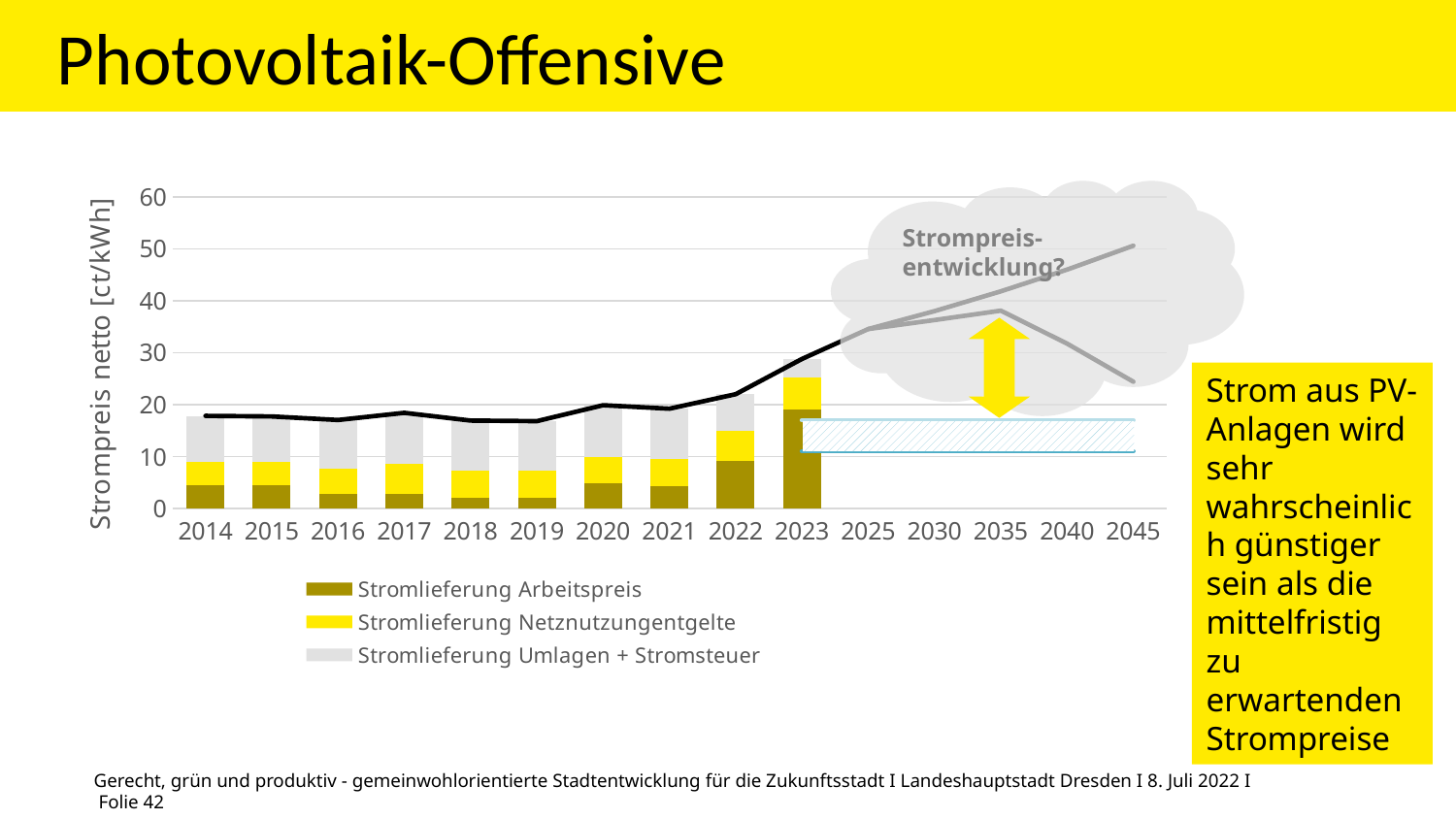
Which year has the highest total stacked bar? 2023 Is the total stacked bar for 2023 greater or less than 20? greater How many series does the legend list? 3 Is the Stromlieferung Arbeitspreis value for 2018 greater or less than 10? less What kind of chart is shown on the slide? Stacked bar chart with a line What is the label of the y axis? Strompreis netto [ct/kWh] Is the Stromlieferung Arbeitspreis value for 2023 greater or less than 10? greater How many years on the x axis have stacked bars plotted? 10 Which legend entry is shown in light grey? Stromlieferung Umlagen + Stromsteuer Which year has the larger total stacked bar, 2014 or 2023? 2023 Does the black line rise or fall from 2021 to 2023? rise